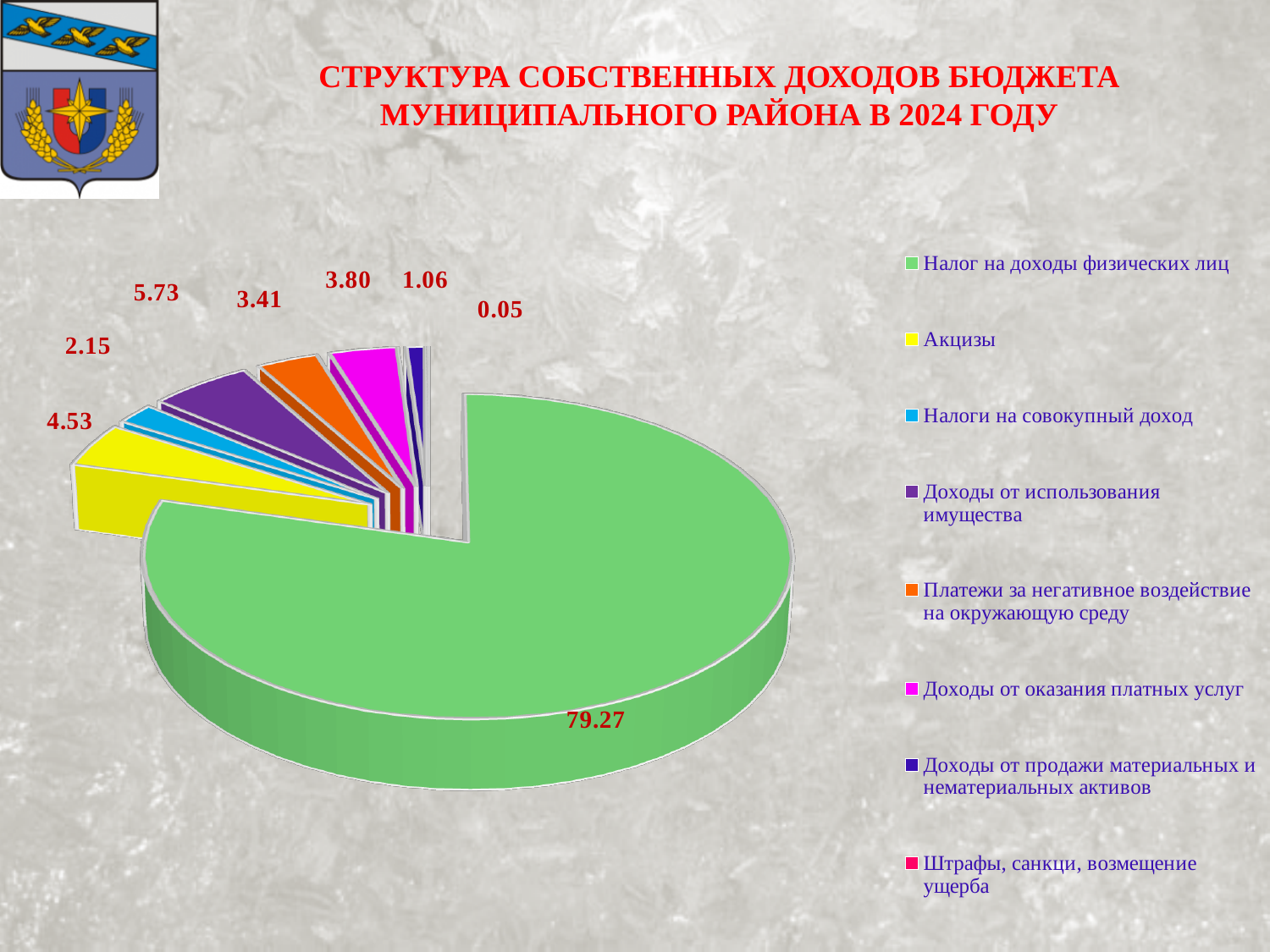
What is the value shown for Штрафы, санкци, возмещение ущерба? 0.05 What is the difference between the values for Доходы от использования имущества and Акцизы? 1.20 Which category has the largest slice of the pie? Налог на доходы физических лиц What kind of chart is shown on the slide? pie chart What colour is the slice for Налог на доходы физических лиц? green Which is larger: the value for Доходы от оказания платных услуг or the value for Налоги на совокупный доход? Доходы от оказания платных услуг What is the value shown for Налог на доходы физических лиц? 79.27 Which category has the smallest slice of the pie? Штрафы, санкци, возмещение ущерба What is the title of the chart? СТРУКТУРА СОБСТВЕННЫХ ДОХОДОВ БЮДЖЕТА МУНИЦИПАЛЬНОГО РАЙОНА В 2024 ГОДУ What is the value shown for Доходы от использования имущества? 5.73 What is the value shown for Акцизы? 4.53 How many categories does the legend list? 8